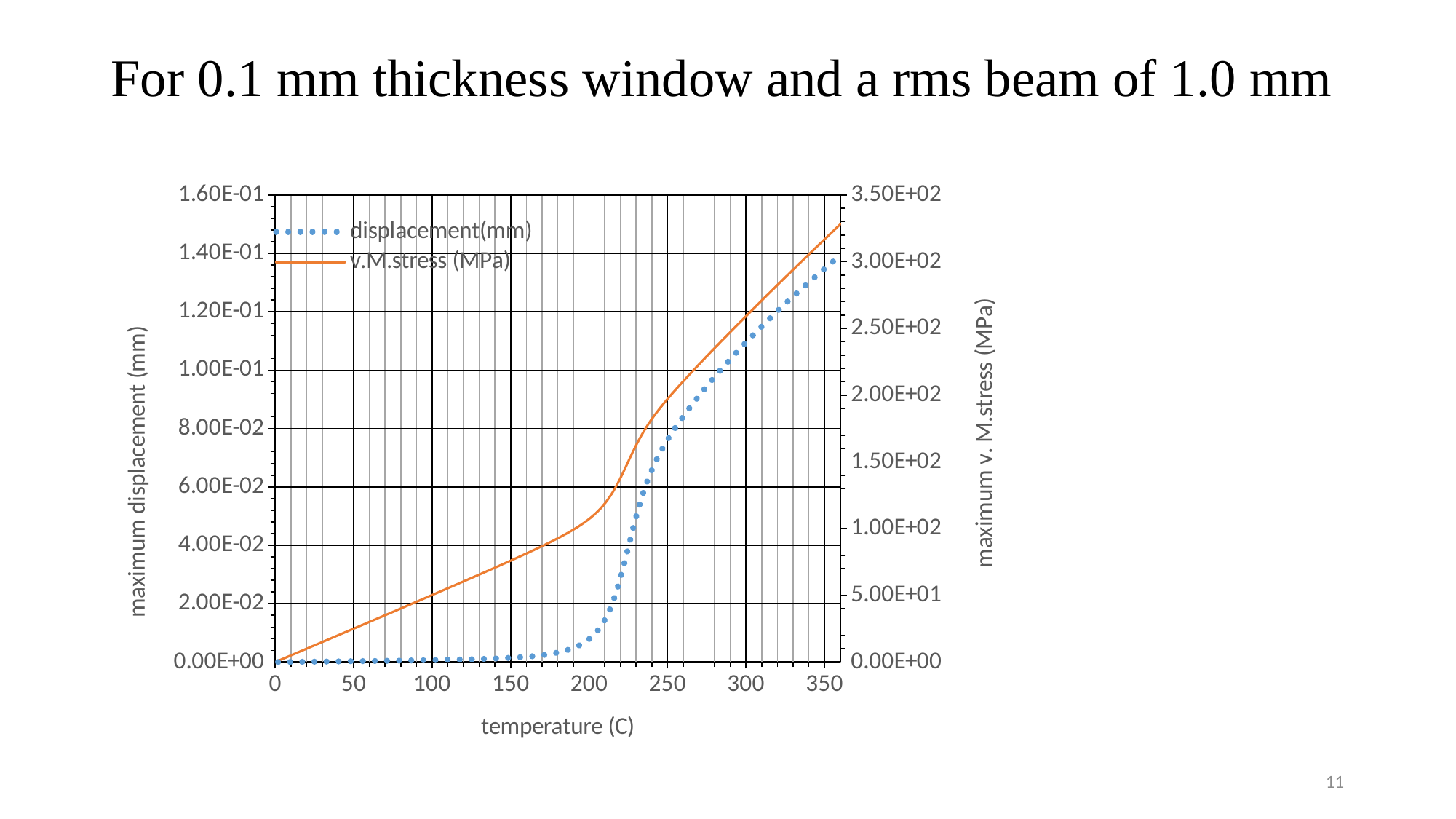
What are the two series named in the legend? displacement(mm) and v.M.stress (MPa) Is the displacement(mm) value at 150 C greater or less than 2.00E-02? less Does the displacement(mm) series rise or fall as temperature increases? rise Is the v.M.stress (MPa) value at 150 C greater or less than 5.00E+01? greater Is the displacement(mm) value at 300 C greater or less than 1.00E-01? greater What is the title of the x axis? temperature (C) How many series does the legend list? 2 What kind of chart is shown on the slide? line chart Does the v.M.stress (MPa) series rise or fall as temperature increases? rise